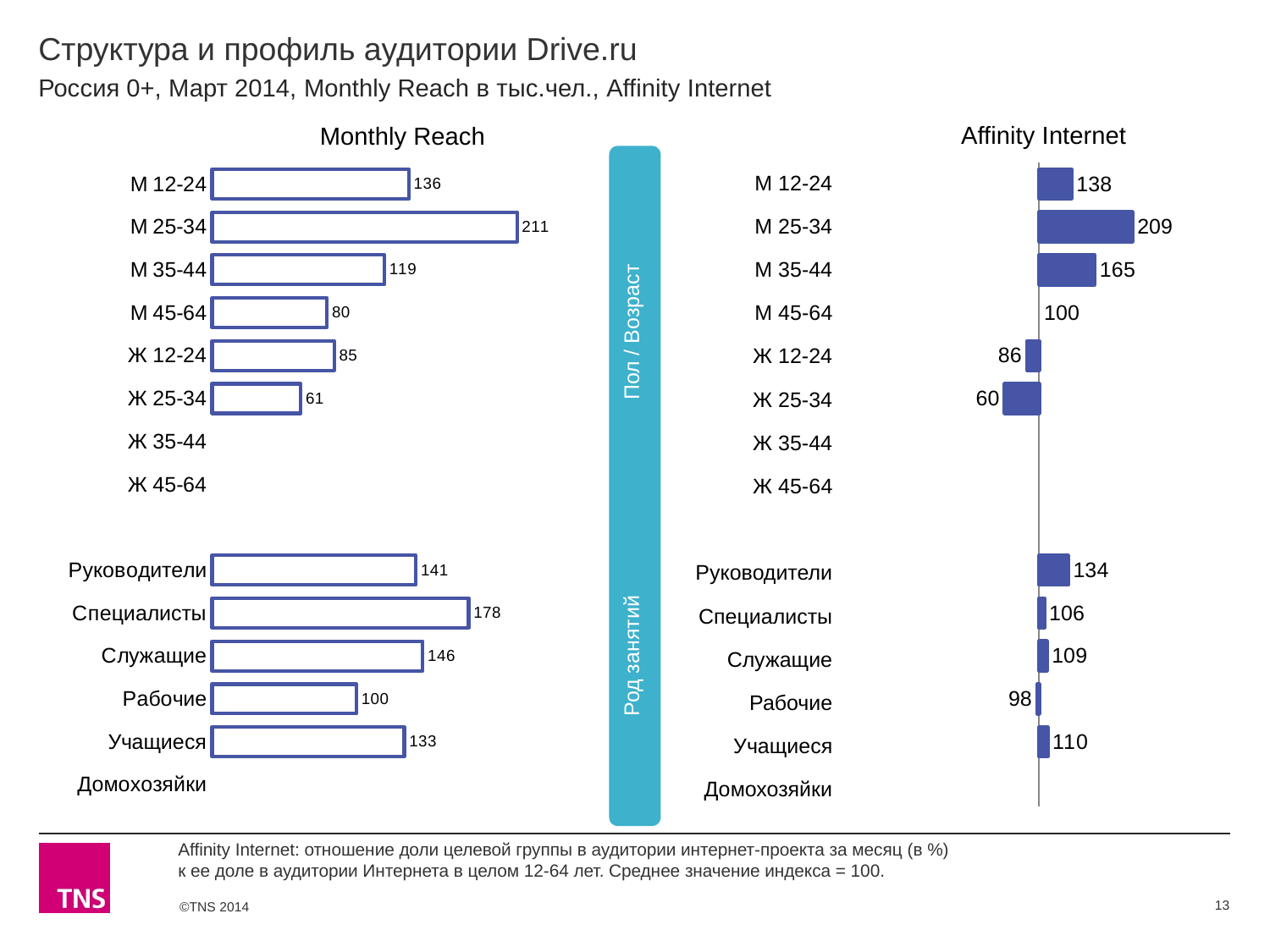
In the Affinity Internet chart, what is the difference between М 25-34 and М 35-44? 44 What type of chart is the Monthly Reach chart? Bar chart In the Affinity Internet chart, what is the value for Руководители? 134 In the Monthly Reach chart, what is the value for Ж 25-34? 61 In the Affinity Internet chart, what is the value for М 45-64? 100 In the Monthly Reach chart, which category has the highest value? М 25-34 In the Monthly Reach chart, which is larger: Руководители or Учащиеся? Руководители In the Affinity Internet chart, which is larger: Ж 12-24 or Рабочие? Рабочие In the Monthly Reach chart, what is the difference between Специалисты and Рабочие? 78 What are the two group labels shown on the vertical band between the charts? Пол / Возраст and Род занятий In the Affinity Internet chart, which category has the lowest value among those with a printed value? Ж 25-34 In the Monthly Reach chart, what is the value for М 25-34? 211